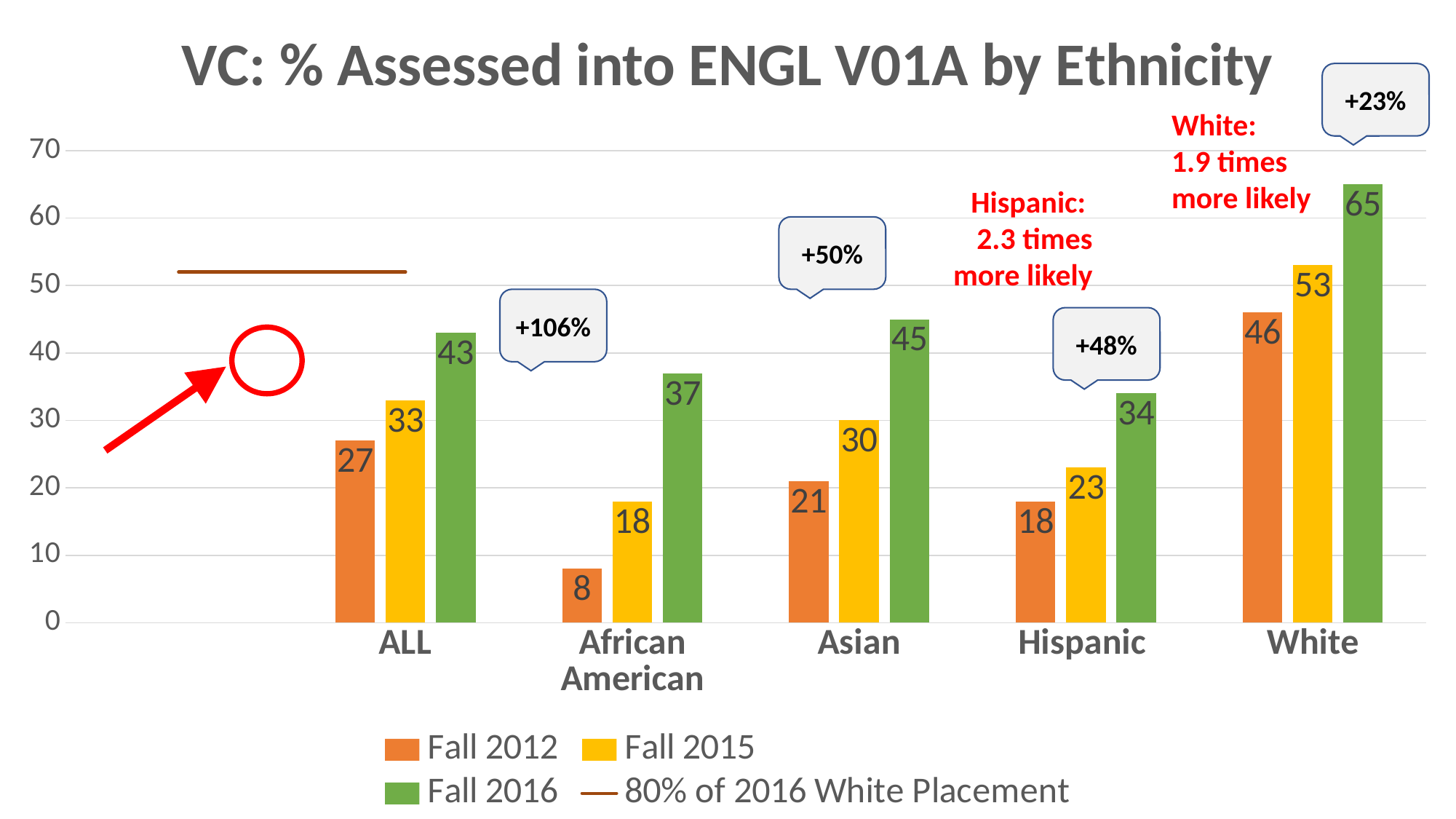
What is the Fall 2012 value for Hispanic? 18 What kind of chart is shown on the slide? Bar chart How many entries does the legend list? 4 Which ethnicity category has the lowest Fall 2012 value? African American How many ethnicity categories are shown on the x axis? 5 Which is larger: the Fall 2015 value for Asian or the Fall 2015 value for Hispanic? Asian What is the Fall 2016 value for African American? 37 What is the Fall 2015 value for White? 53 Is the Fall 2016 value for ALL greater or less than 40? greater What is the difference between the Fall 2016 and Fall 2012 values for Asian? 24 Do the values for White rise or fall from Fall 2012 to Fall 2016? Rise Which ethnicity category has the highest Fall 2016 value? White